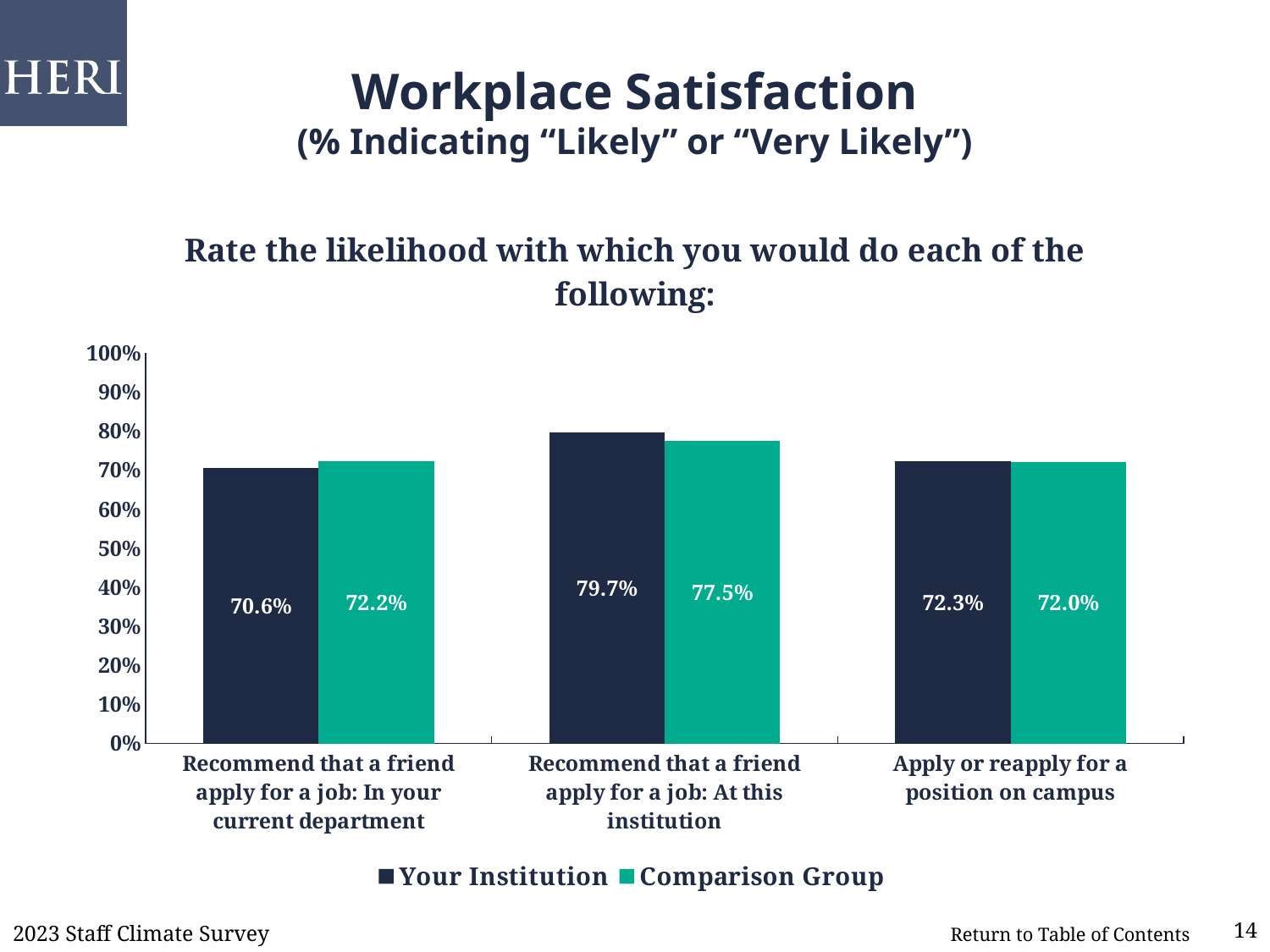
What kind of chart is shown on the slide? Bar chart For "Recommend that a friend apply for a job: In your current department", which is larger: Your Institution or Comparison Group? Comparison Group What are the two series named in the legend? Your Institution and Comparison Group What is the difference between Your Institution and Comparison Group for "Recommend that a friend apply for a job: At this institution"? 2.2 percentage points How many categories are shown on the x axis? 3 Which category has the highest value for Your Institution? Recommend that a friend apply for a job: At this institution How many series does the legend list? 2 Which category has the lowest value for Your Institution? Recommend that a friend apply for a job: In your current department Is the Comparison Group value for "Apply or reapply for a position on campus" greater or less than 80%? less What is the value for Your Institution for "Recommend that a friend apply for a job: In your current department"? 70.6% What is the value for Your Institution for "Apply or reapply for a position on campus"? 72.3% What is the value for Comparison Group for "Recommend that a friend apply for a job: At this institution"? 77.5%